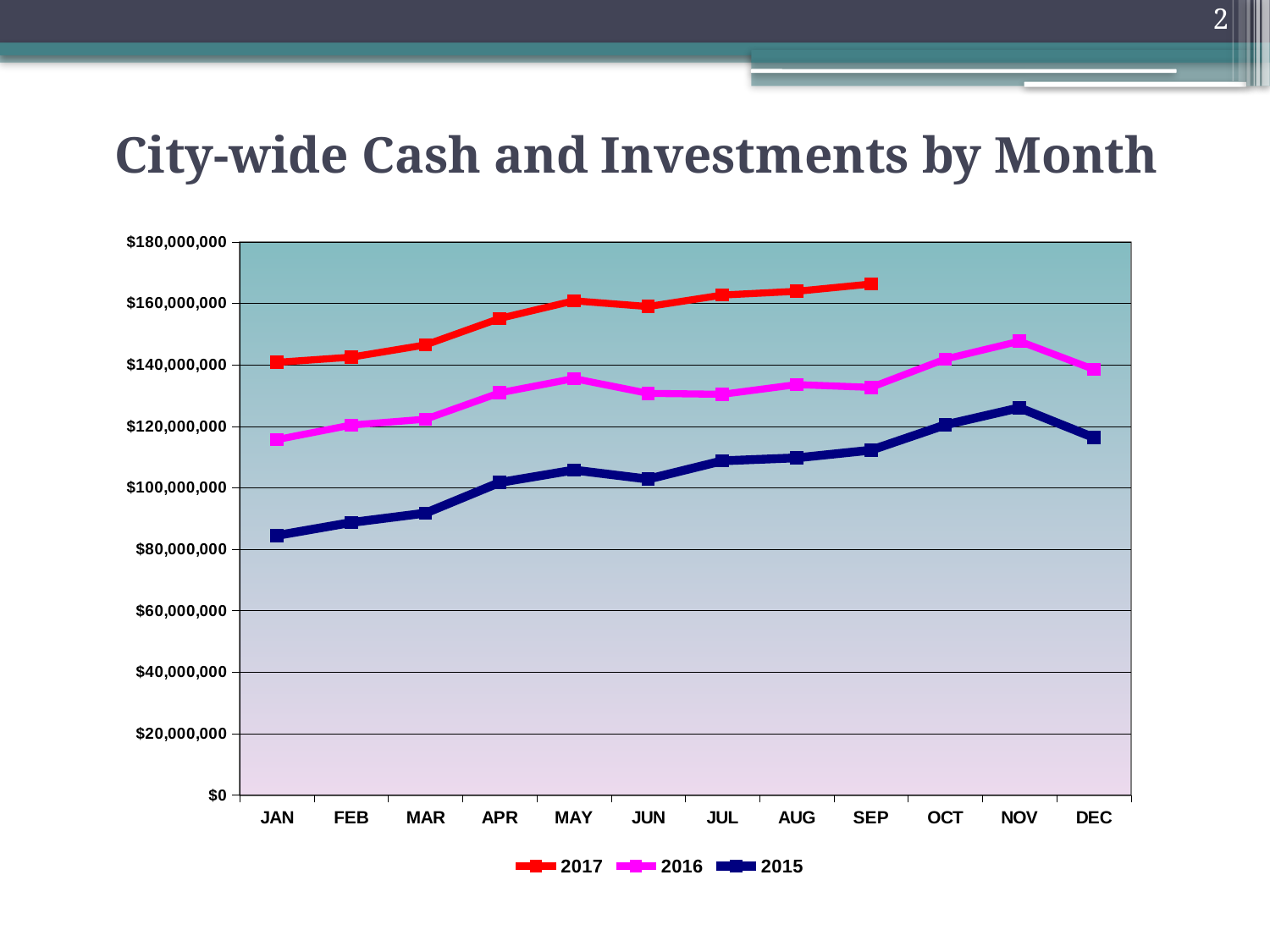
In which month is the 2017 series at its highest? SEP Through which month does the 2017 series have data points? SEP Is the value for 2015 in JAN greater or less than $80,000,000? greater How many months are shown on the x axis? 12 In which month is the 2016 series at its lowest? JAN In which month is the 2015 series at its highest? NOV What kind of chart is shown on the slide? line chart What is the title of the chart? City-wide Cash and Investments by Month Is the value for 2017 in SEP greater or less than $160,000,000? greater Is the value for 2015 in DEC greater or less than $120,000,000? less How many series does the legend list? 3 Which series has the larger value in MAY, 2017 or 2016? 2017